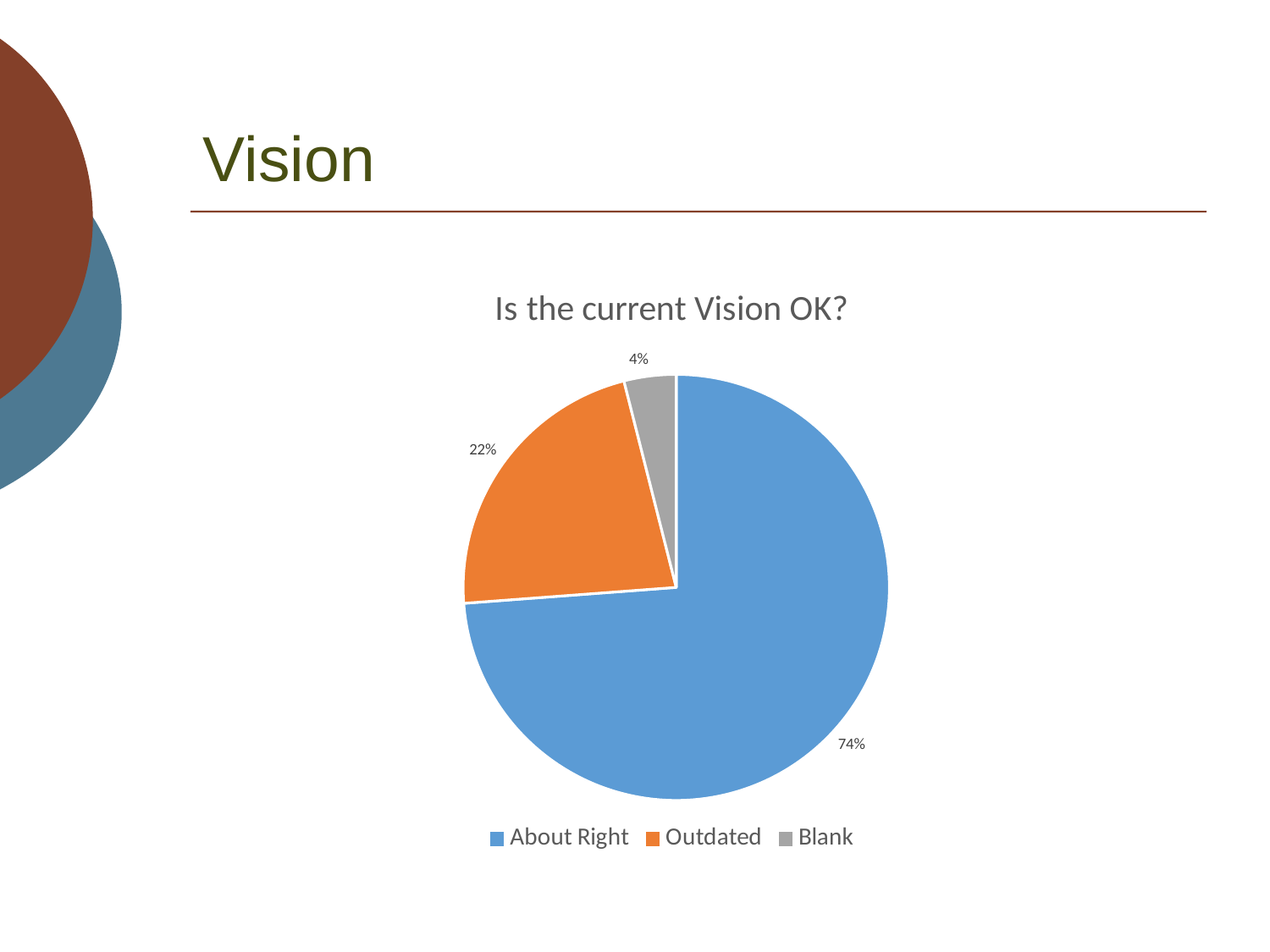
How many categories does the legend list? 3 What colour is the "Outdated" slice? orange Which category has the largest share of the pie? About Right What is the difference in percentage points between "About Right" and "Outdated"? 52 Which category has the smallest share of the pie? Blank What kind of chart is shown on the slide? pie chart What percentage of responses are "About Right"? 74% What percentage of responses are "Blank"? 4% What is the title of the chart? Is the current Vision OK? What percentage of responses are "Outdated"? 22% Which is larger, the share for "Outdated" or the share for "Blank"? Outdated What is the combined share of "Outdated" and "Blank"? 26%